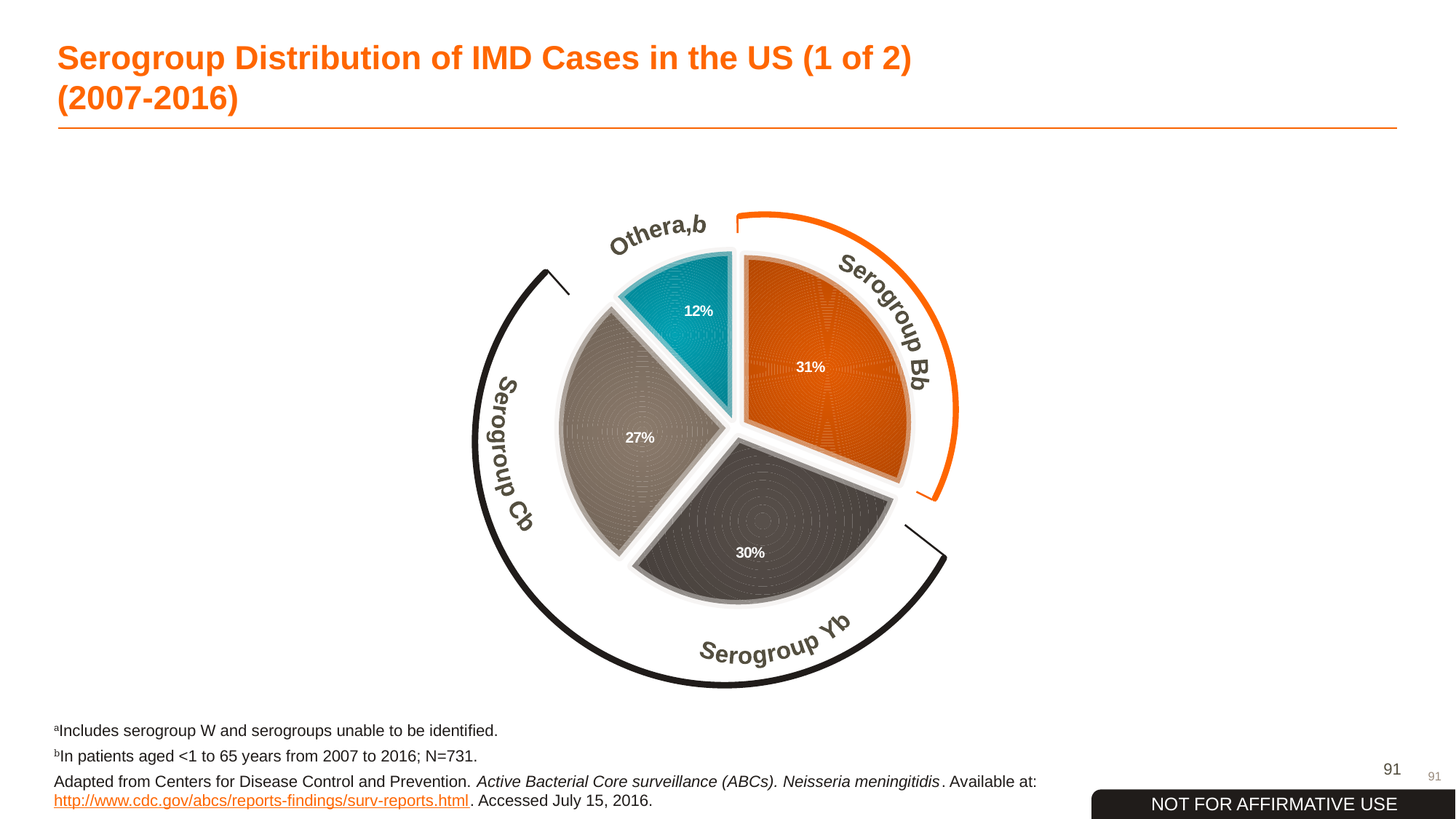
What is the difference in percentage points between Serogroup B and the Other category? 19 Which serogroup category has the largest share of IMD cases? Serogroup B Which has a larger share of IMD cases, Serogroup C or the Other category? Serogroup C What percentage of IMD cases is attributed to Serogroup C? 27% Which category has the smallest share of IMD cases? Other What percentage of IMD cases is attributed to Serogroup B? 31% What colour is the Serogroup B slice? Orange How many slices does the pie chart have? 4 What kind of chart is shown on the slide? Pie chart What is the difference in percentage points between Serogroup Y and Serogroup C? 3 What percentage of IMD cases falls in the Other category? 12% What percentage of IMD cases is attributed to Serogroup Y? 30%